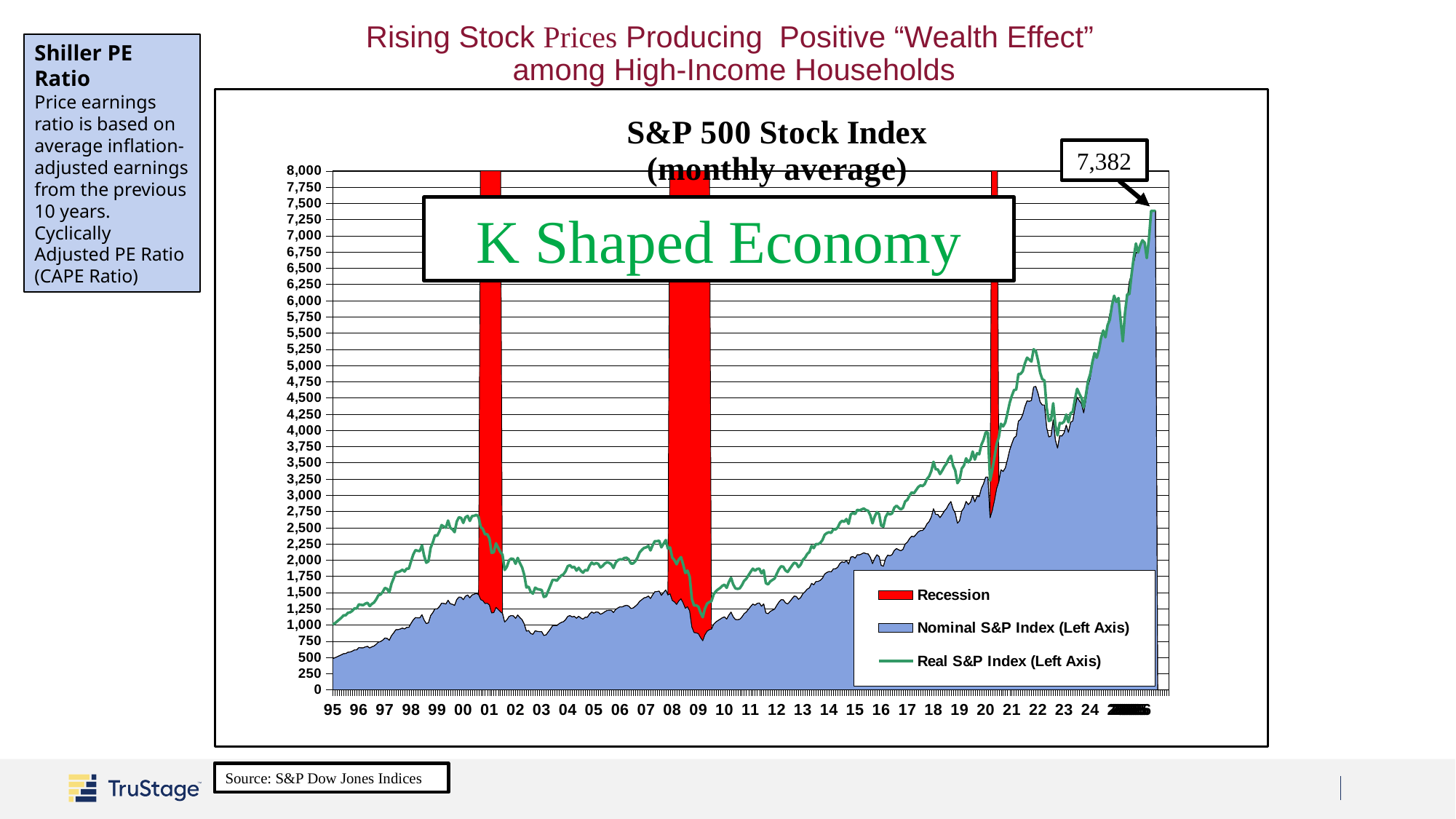
Around 00, which is higher: the Real S&P Index or the Nominal S&P Index? Real S&P Index How many recession periods are shaded on the chart? 3 What is the title of the chart? S&P 500 Stock Index (monthly average) Is the Nominal S&P Index in 95 greater or less than 1,000? less What source is cited for the chart? S&P Dow Jones Indices How many entries does the chart's legend list? 3 What value is labeled at the end of the S&P 500 series on the chart? 7,382 Does the Nominal S&P Index generally rise or fall from 95 to the end of the chart? rise Is the Real S&P Index at its peak around 00 greater or less than 2,000? greater Is the Nominal S&P Index at its low point in 09 greater or less than 1,000? less What kind of chart is used to show the S&P 500 Stock Index? combination area and line chart